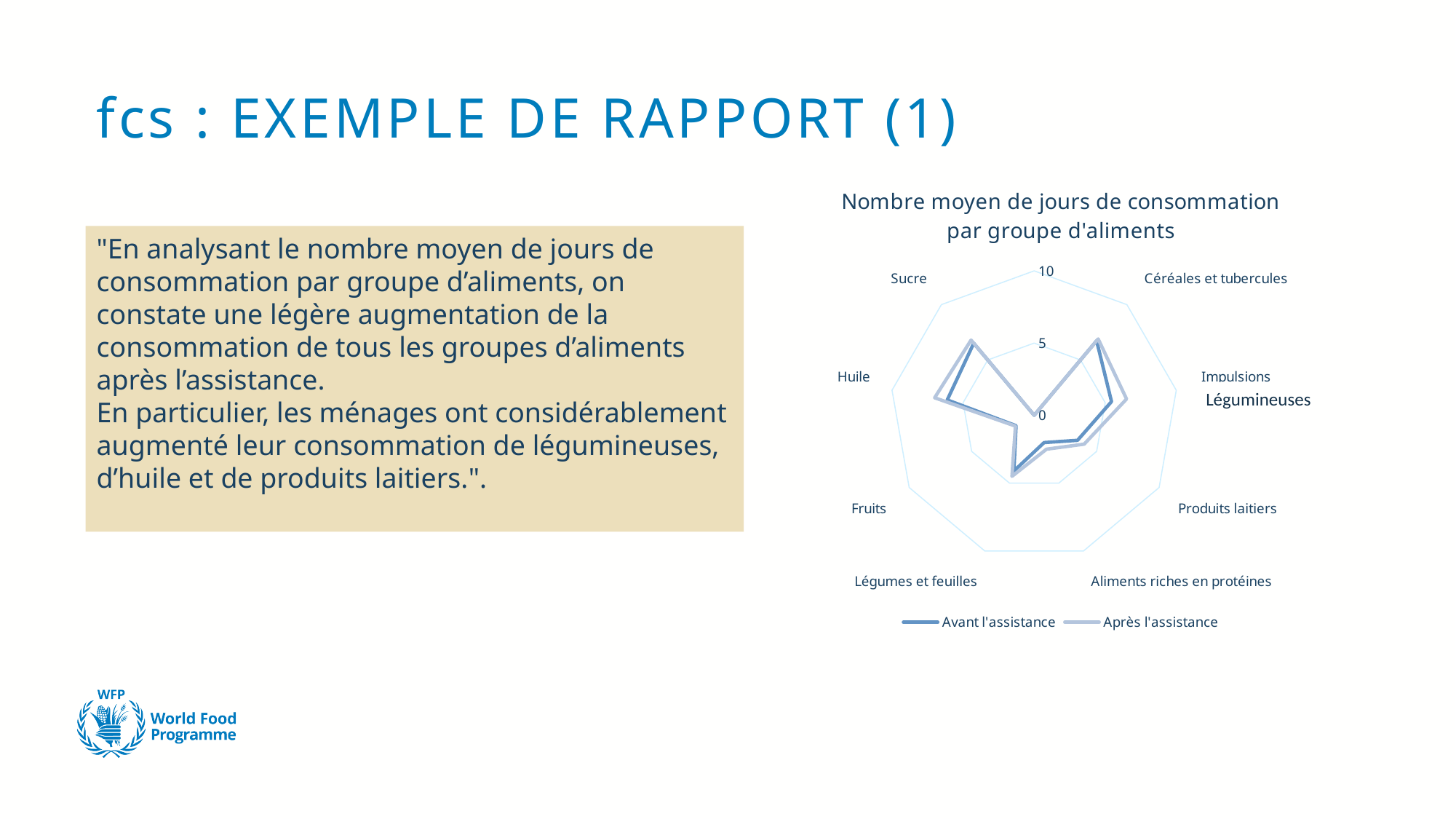
How many food group categories are plotted on the radar chart? 8 What are the two series named in the legend? Avant l'assistance and Après l'assistance Is the value for Légumes et feuilles greater or less than 5? less Which has a higher value, Céréales et tubercules or Aliments riches en protéines? Céréales et tubercules Is the value for Aliments riches en protéines greater or less than 5? less What is the title of the chart? Nombre moyen de jours de consommation par groupe d'aliments Is the value for Sucre greater or less than 5? greater Which food group has the lowest value on the chart? Fruits Which has a higher value, Sucre or Légumes et feuilles? Sucre What kind of chart is shown on the slide? Radar chart How many series does the chart's legend list? 2